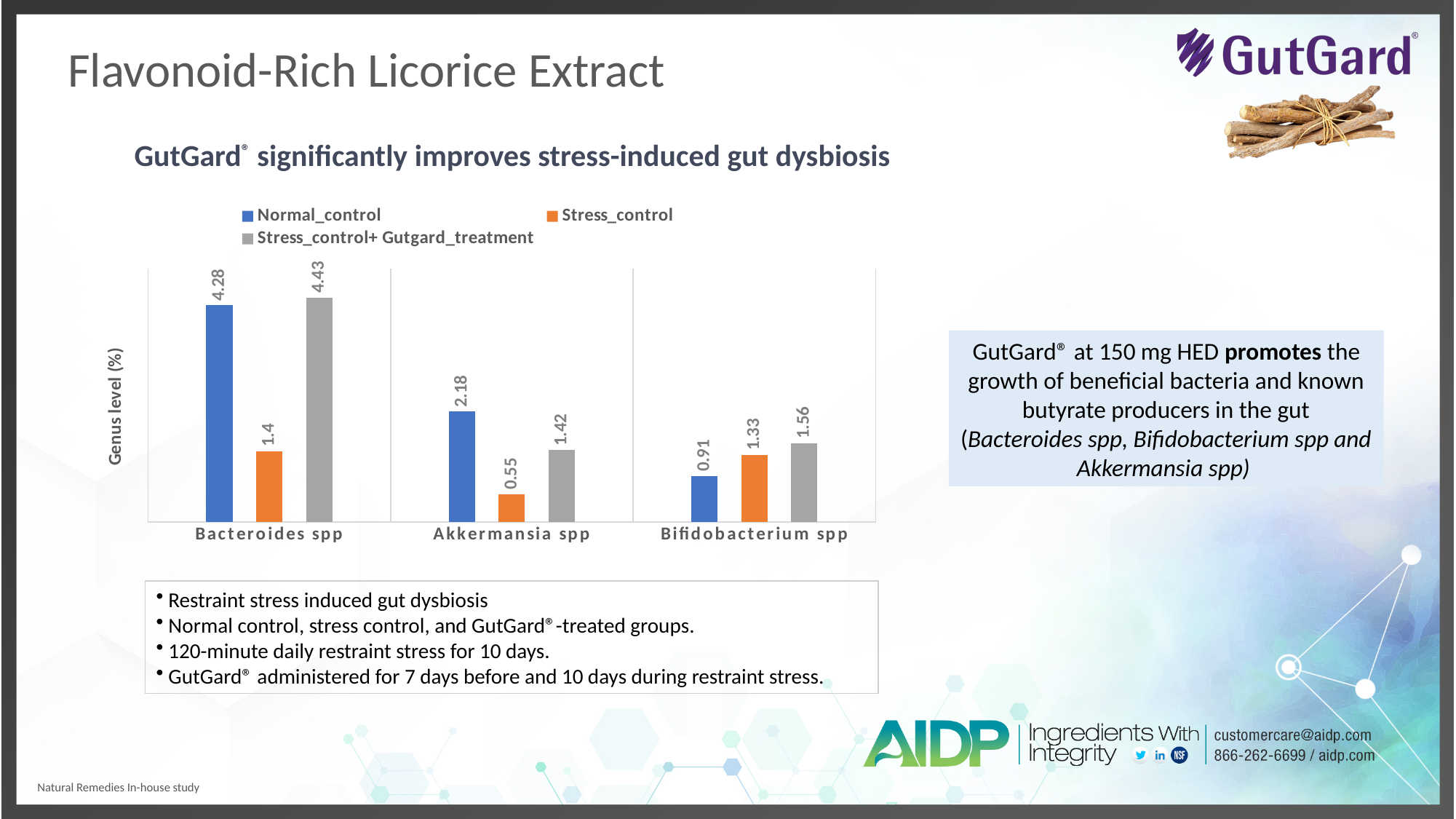
What is the label of the y axis? Genus level (%) Which is larger for Akkermansia spp: the Normal_control value or the Stress_control+ Gutgard_treatment value? Normal_control What is the difference between the Stress_control+ Gutgard_treatment and Stress_control values for Bacteroides spp? 3.03 Which colour represents the Stress_control series? Orange Which series has the lowest value for Bifidobacterium spp? Normal_control What kind of chart is shown on the slide? Bar chart How many series does the legend list? 3 What is the Normal_control value for Bacteroides spp? 4.28 Which series has the highest value for Bacteroides spp? Stress_control+ Gutgard_treatment What is the Stress_control+ Gutgard_treatment value for Bifidobacterium spp? 1.56 How many bacterial genera (categories) are shown on the x axis? 3 What is the Stress_control value for Akkermansia spp? 0.55